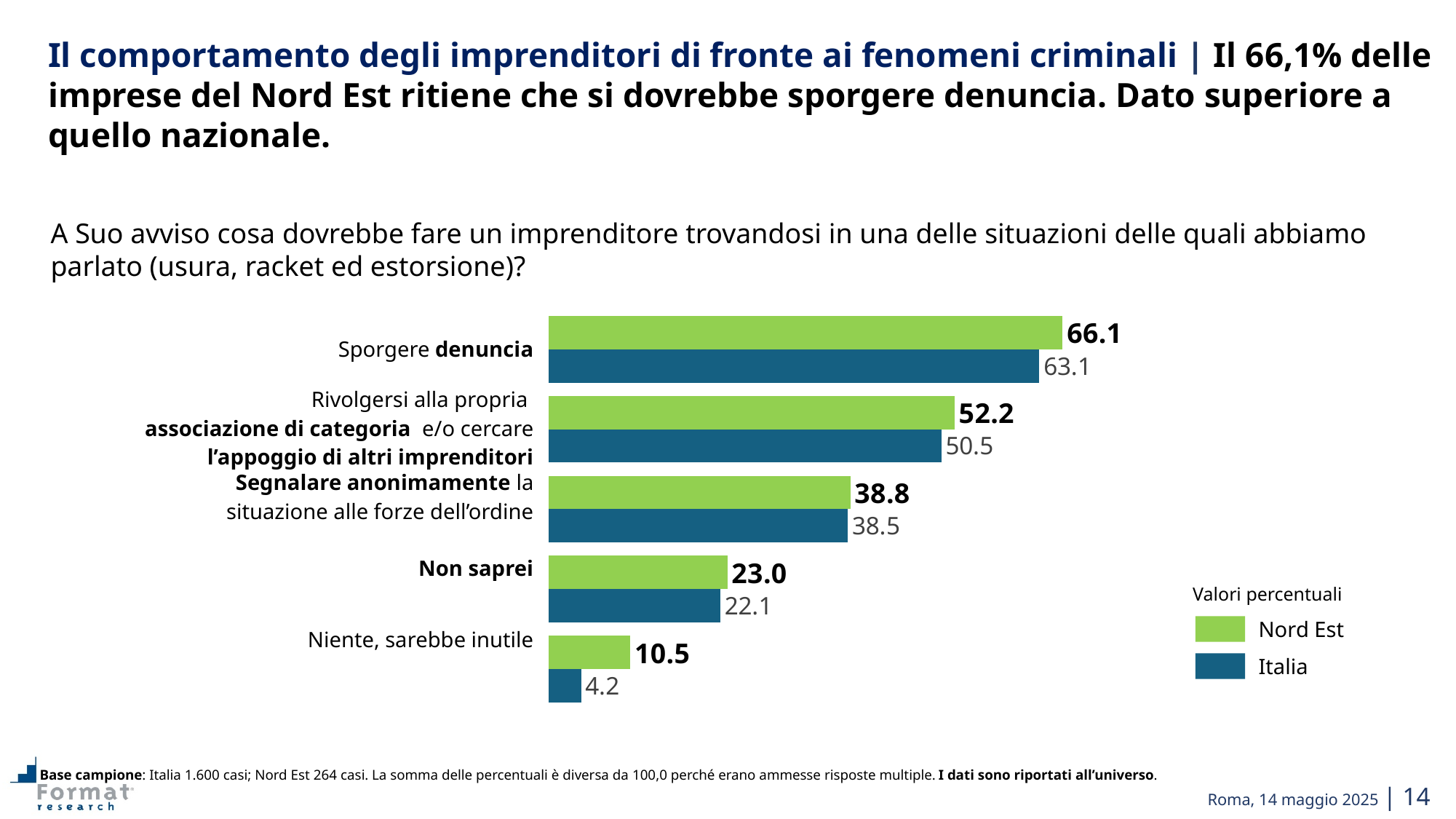
What is the difference between the Nord Est and Italia values for "Niente, sarebbe inutile"? 6.3 How many series does the legend list? 2 What is the Nord Est value for "Segnalare anonimamente la situazione alle forze dell'ordine"? 38.8 For "Non saprei", which series has the larger value, Nord Est or Italia? Nord Est What is the Nord Est value for "Sporgere denuncia"? 66.1 Which category has the lowest Italia value? Niente, sarebbe inutile What is the difference between the Nord Est and Italia values for "Sporgere denuncia"? 3.0 What is the Italia value for "Niente, sarebbe inutile"? 4.2 What kind of chart is shown on the slide? Bar chart How many categories are shown in the chart? 5 What is the Italia value for "Non saprei"? 22.1 Which category has the highest Nord Est value? Sporgere denuncia